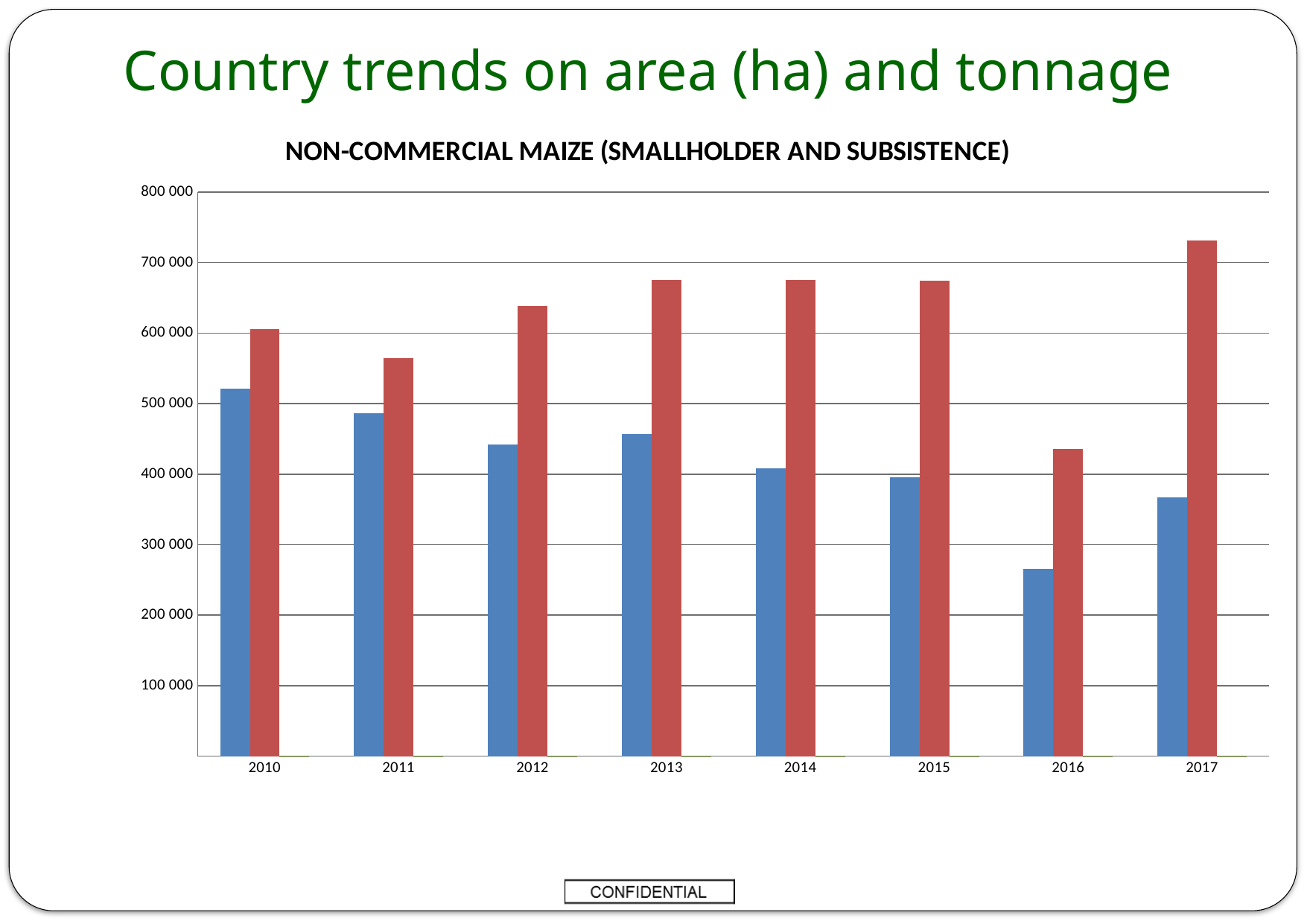
In 2010, which bar is taller, the blue bar or the red bar? The red bar In which year is the blue bar the highest? 2010 How many years are shown on the x axis of the chart? 8 In which year is the red bar the highest? 2017 In which year is the blue bar the lowest? 2016 Is the value of the red bar for 2011 greater or less than 600 000? less What kind of chart is shown on the slide? Bar chart What is the title of the chart? NON-COMMERCIAL MAIZE (SMALLHOLDER AND SUBSISTENCE) Is the value of the blue bar for 2016 greater or less than 300 000? less In which year is the red bar the lowest? 2016 Is the value of the red bar for 2017 greater or less than 700 000? greater Do the blue bars generally rise or fall from 2010 to 2016? Fall